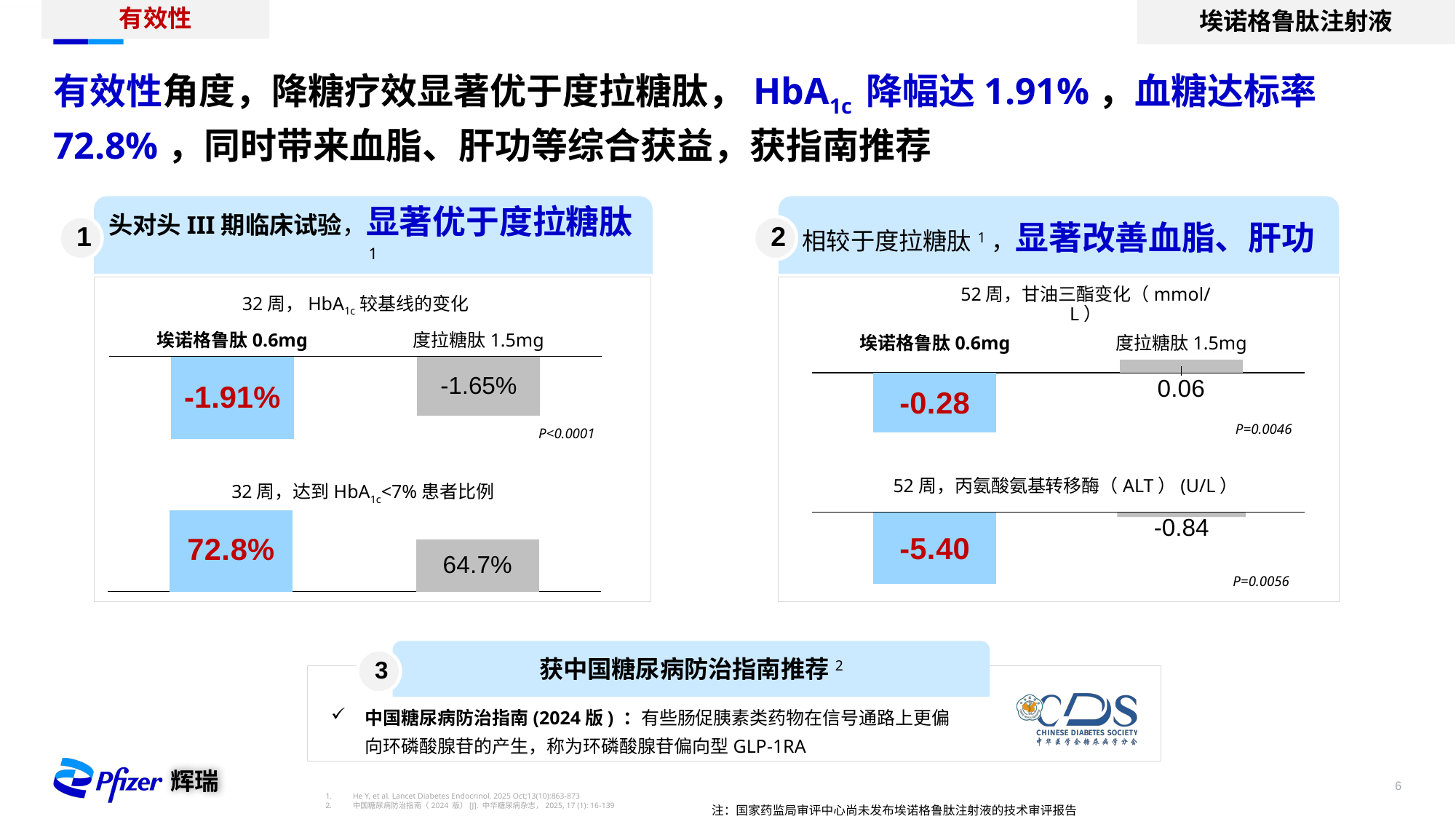
在“52周，甘油三酯变化（mmol/L）”图中，埃诺格鲁肽 0.6mg 的数值是多少？ -0.28 在“32周，达到HbA1c<7%患者比例”图中，哪一组的比例更高？ 埃诺格鲁肽 0.6mg 在“32周，HbA1c较基线的变化”图中，埃诺格鲁肽 0.6mg 的数值是多少？ -1.91% 在“52周，丙氨酸氨基转移酶（ALT）(U/L)”图中，埃诺格鲁肽 0.6mg 的数值是多少？ -5.40 “32周，HbA1c较基线的变化”图中有几个分组（柱子）？ 2 “52周，甘油三酯变化（mmol/L）”图是什么类型的图表？ 条形图 在“32周，达到HbA1c<7%患者比例”图中，埃诺格鲁肽 0.6mg 的比例是多少？ 72.8% 在“32周，HbA1c较基线的变化”图中，度拉糖肽 1.5mg 的数值是多少？ -1.65% 在“52周，甘油三酯变化（mmol/L）”图中，度拉糖肽 1.5mg 的数值是多少？ 0.06 在“32周，达到HbA1c<7%患者比例”图中，度拉糖肽 1.5mg 的比例是多少？ 64.7% 在“52周，丙氨酸氨基转移酶（ALT）(U/L)”图中，度拉糖肽 1.5mg 的数值是多少？ -0.84 在“32周，达到HbA1c<7%患者比例”图中，埃诺格鲁肽 0.6mg 与度拉糖肽 1.5mg 的比例相差多少？ 8.1%